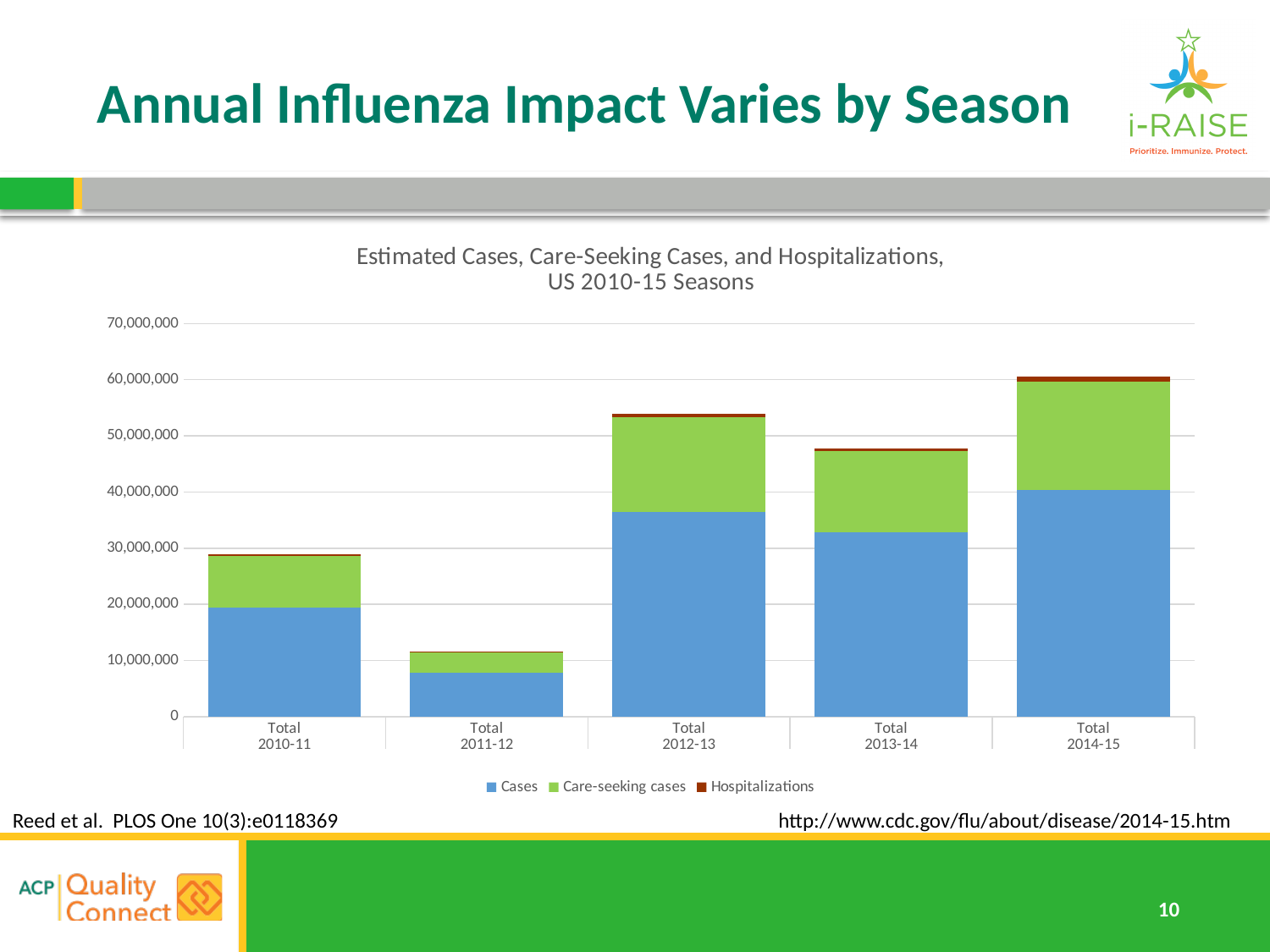
Is the total stacked bar for 2011-12 greater or less than 20,000,000? less What kind of chart is shown on the slide? Stacked bar chart Which series is shown in green in the legend? Care-seeking cases How many series does the legend list? 3 Which season has the tallest stacked bar overall? Total 2014-15 How many seasons (categories) are shown on the x axis? 5 Which season has the shortest stacked bar overall? Total 2011-12 What is the title of the chart? Estimated Cases, Care-Seeking Cases, and Hospitalizations, US 2010-15 Seasons Is the Cases value for 2012-13 greater or less than 30,000,000? greater Is the Cases value for 2011-12 greater or less than 10,000,000? less Which season has the larger total bar, 2012-13 or 2013-14? 2012-13